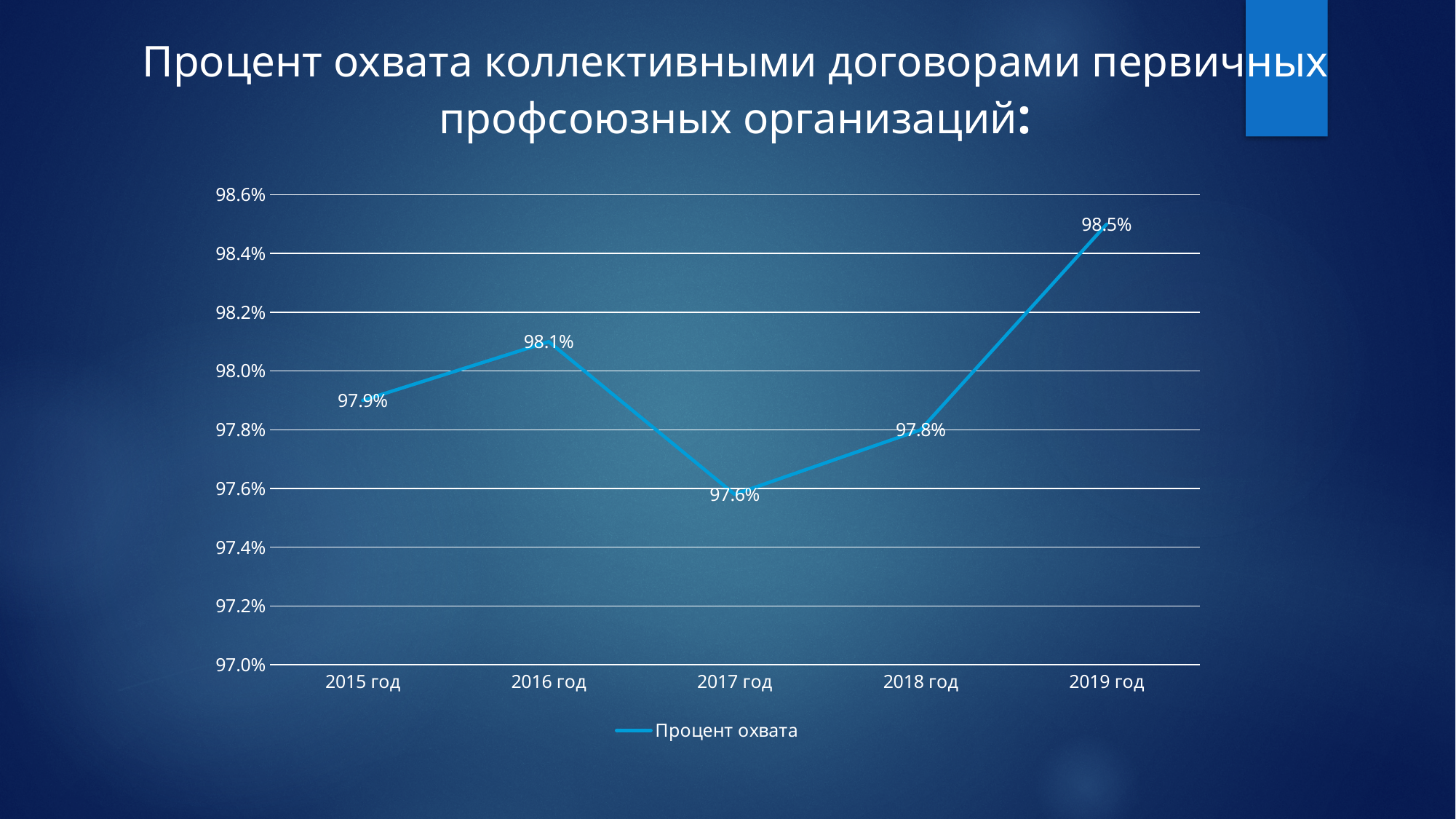
What is the name of the series in the legend? Процент охвата Which year has the highest value? 2019 год What is the value for 2015 год? 97.9% Which year has the lowest value? 2017 год Is the value for 2018 год greater or less than 98.0%? less What is the value for 2017 год? 97.6% How many series does the legend list? 1 How many years are shown on the x axis? 5 What is the difference between the values for 2019 год and 2017 год? 0.9% Which is larger, the value for 2016 год or the value for 2018 год? 2016 год What kind of chart is shown? line chart What is the value for 2019 год? 98.5%